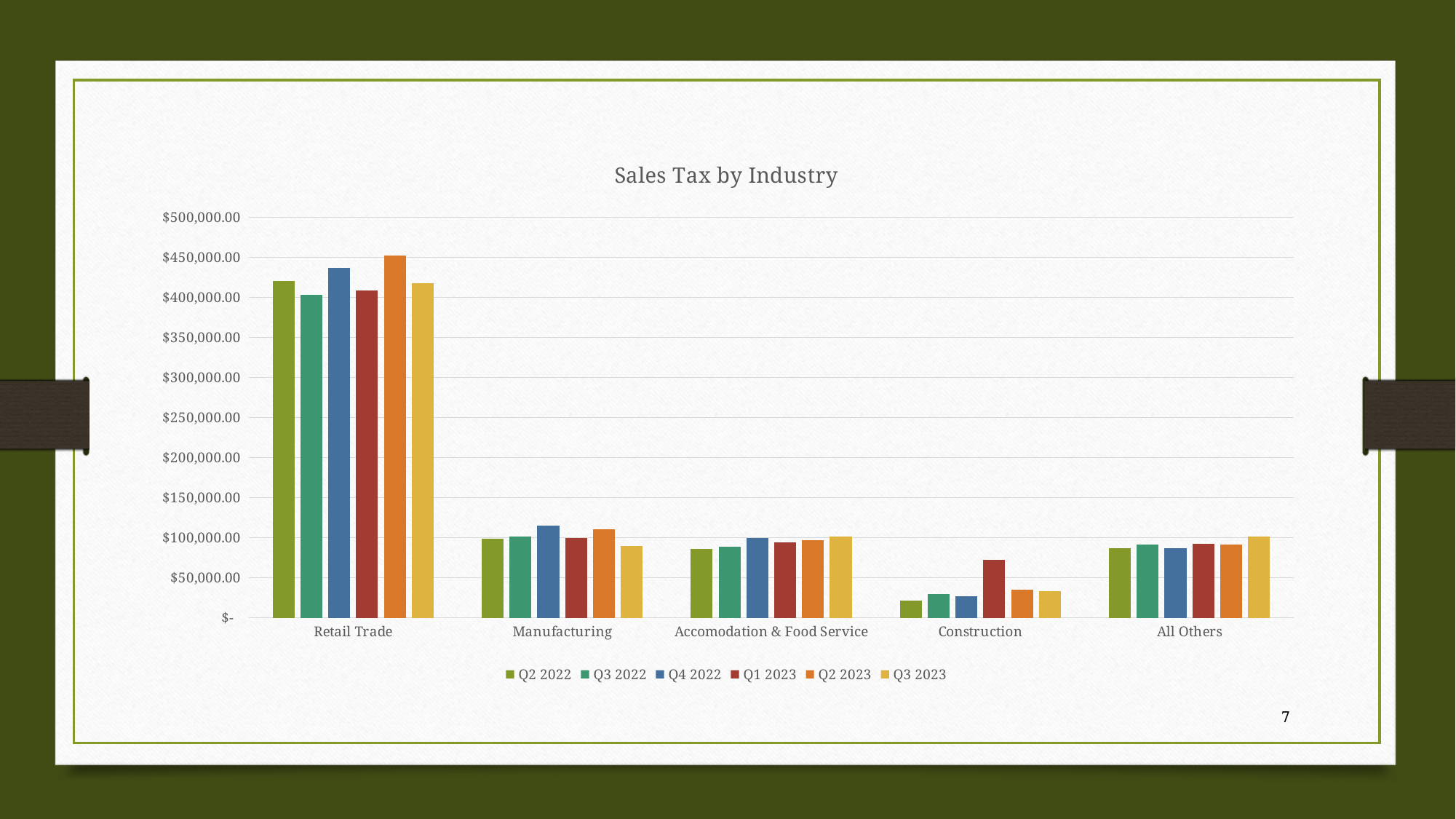
What is the title of the chart? Sales Tax by Industry What kind of chart is shown on the slide? Bar chart For Construction, which quarter has the highest value? Q1 2023 Is the value for Construction in Q1 2023 greater or less than $50,000.00? greater Which industry has the lowest sales tax values in the chart? Construction How many series does the legend of the Sales Tax by Industry chart list? 6 Which industry has the highest sales tax values in the chart? Retail Trade Is the value for Manufacturing in Q4 2022 greater or less than $100,000.00? greater Is the value for Construction in Q2 2022 greater or less than $50,000.00? less For Retail Trade, which is larger: the Q2 2023 value or the Q3 2022 value? Q2 2023 How many industry categories are shown on the x axis of the chart? 5